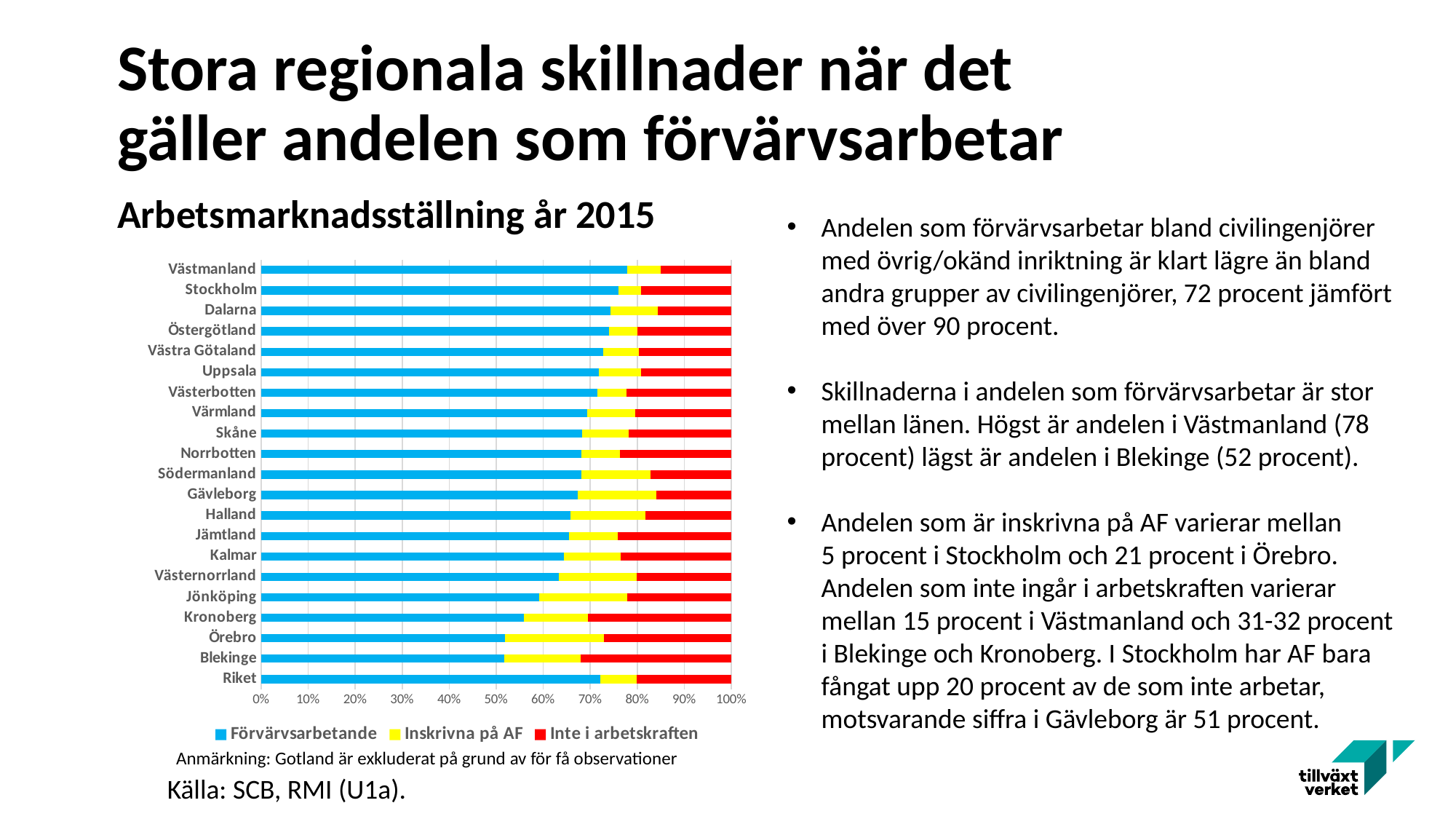
Going from the top of the chart to the bottom, does the Förvärvsarbetande share rise or fall? fall Is the Förvärvsarbetande share for Blekinge greater or less than 60%? less Is the Förvärvsarbetande share for Kronoberg greater or less than 60%? less What is the title of the chart? Arbetsmarknadsställning år 2015 What kind of chart is shown on the slide? Stacked bar chart How many series does the chart's legend list? 3 Which has the larger Förvärvsarbetande share, Västmanland or Blekinge? Västmanland Which colour represents Inte i arbetskraften in the chart? Red Is the Förvärvsarbetande share for Västmanland greater or less than 70%? greater Which region has the highest share of Förvärvsarbetande? Västmanland How many categories (regions including Riket) are plotted in the chart? 21